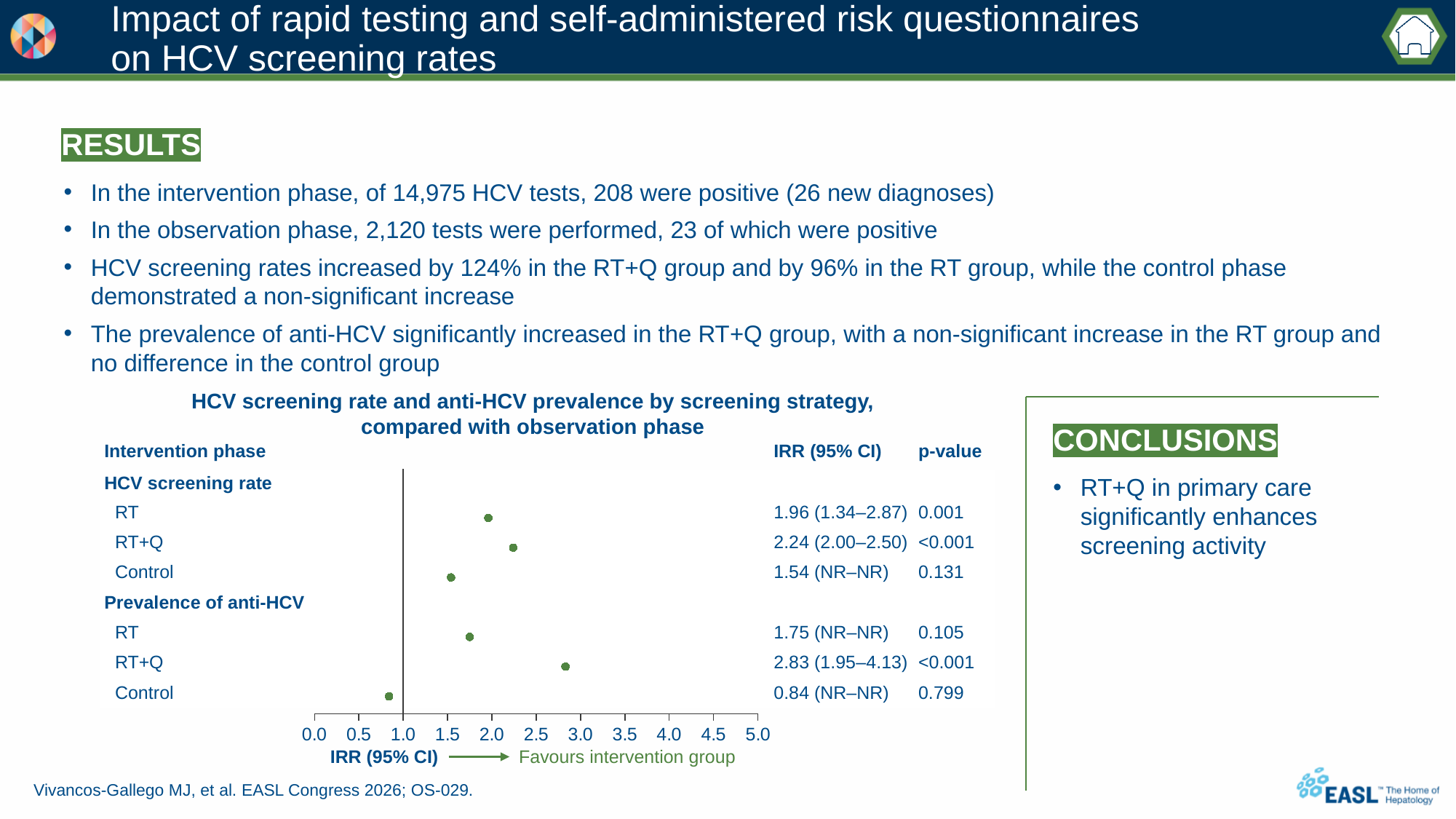
Which row in the chart has the lowest IRR? Control (Prevalence of anti-HCV), 0.84 What kind of chart is shown on the slide? Forest plot (dot plot) Which row in the chart has the highest IRR? RT+Q (Prevalence of anti-HCV), 2.83 What is the difference between the IRR for RT+Q and the IRR for RT in the Prevalence of anti-HCV section? 1.08 How many data points are plotted in the chart? 6 What is the difference between the IRR for RT+Q and the IRR for RT in the HCV screening rate section? 0.28 Is the IRR for Control in the Prevalence of anti-HCV section greater or less than 1.0? less In the HCV screening rate section, which has the larger IRR, RT or Control? RT What is the p-value for RT in the HCV screening rate section? 0.001 What is the IRR for Control in the Prevalence of anti-HCV section of the chart? 0.84 What is the 95% CI for RT+Q in the Prevalence of anti-HCV section? 1.95–4.13 What is the IRR for RT+Q in the HCV screening rate section of the chart? 2.24